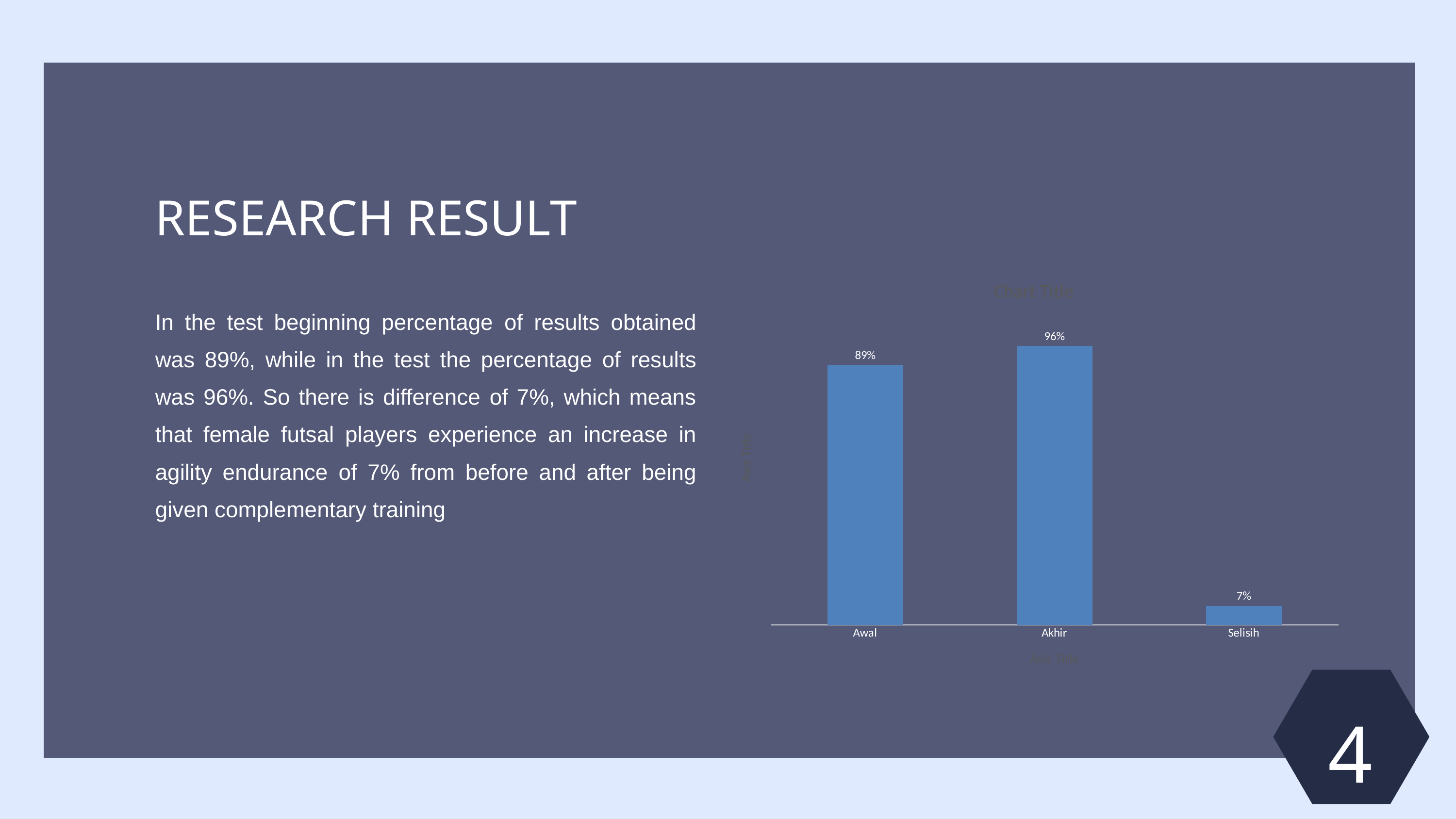
Which is larger, the value for Awal or the value for Akhir? Akhir How many categories are shown on the x axis? 3 Which category has the lowest value? Selisih What is the difference between the values for Awal and Selisih? 82% What is the difference between the values for Akhir and Awal? 7% What is the label of the first category on the x axis? Awal What is the value for Awal? 89% What kind of chart is shown on the slide? bar chart What is the value for Selisih? 7% Which category has the highest value? Akhir What is the value for Akhir? 96% What colour are the bars in the chart? blue